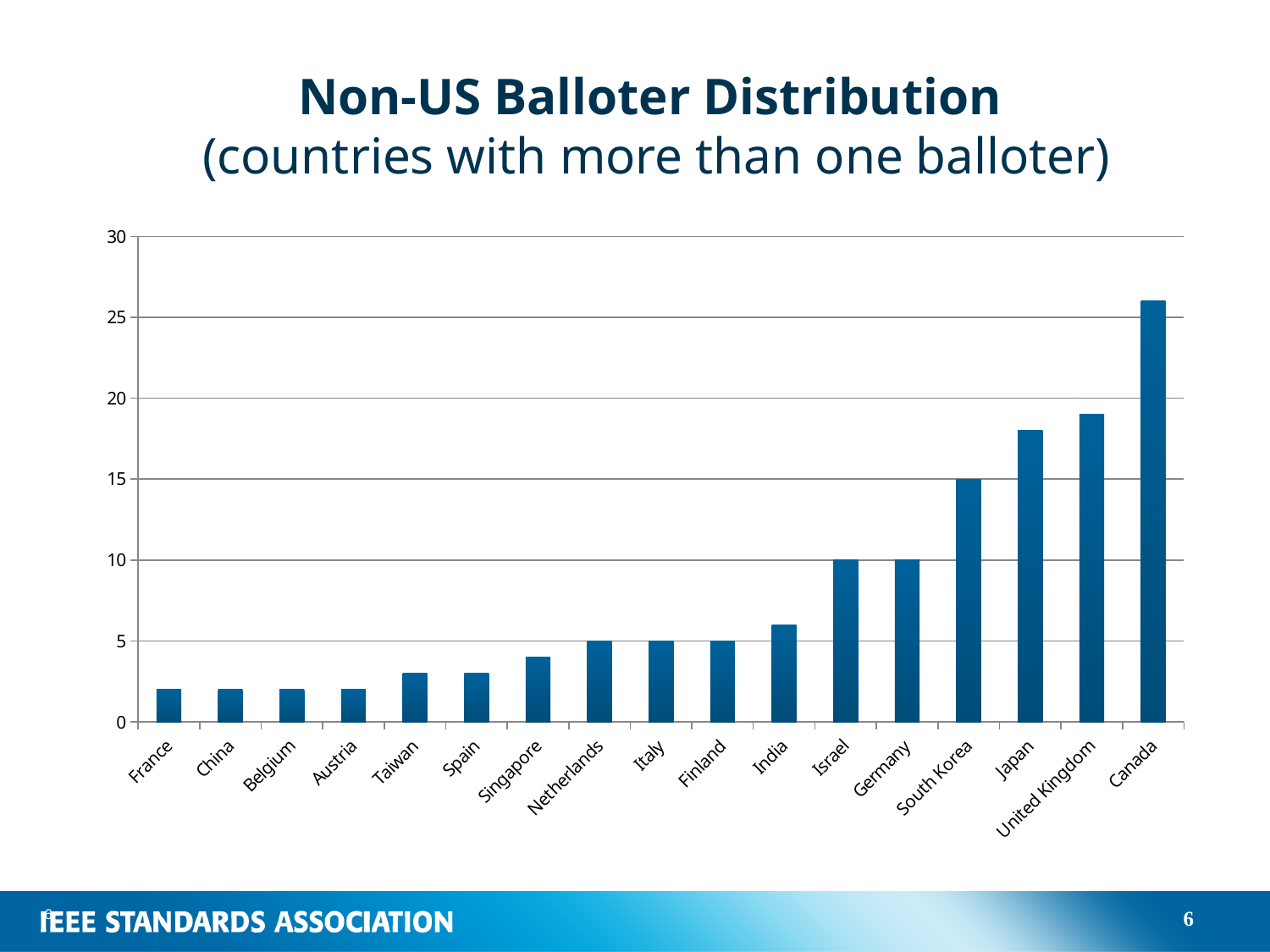
Do the values generally rise or fall moving from left to right along the x axis? rise What is the difference between the values for Israel and Netherlands? 5 Is the value for France greater or less than 5? less Is the value for Japan greater or less than 20? less What type of chart is shown on the slide? bar chart Which has a larger value, United Kingdom or Canada? Canada What is the value for Israel? 10 Which country has the highest number of balloters in the chart? Canada How many countries are shown on the x axis of the chart? 17 Is the value for Canada greater or less than 25? greater What is the value for South Korea? 15 What is the value for Netherlands? 5